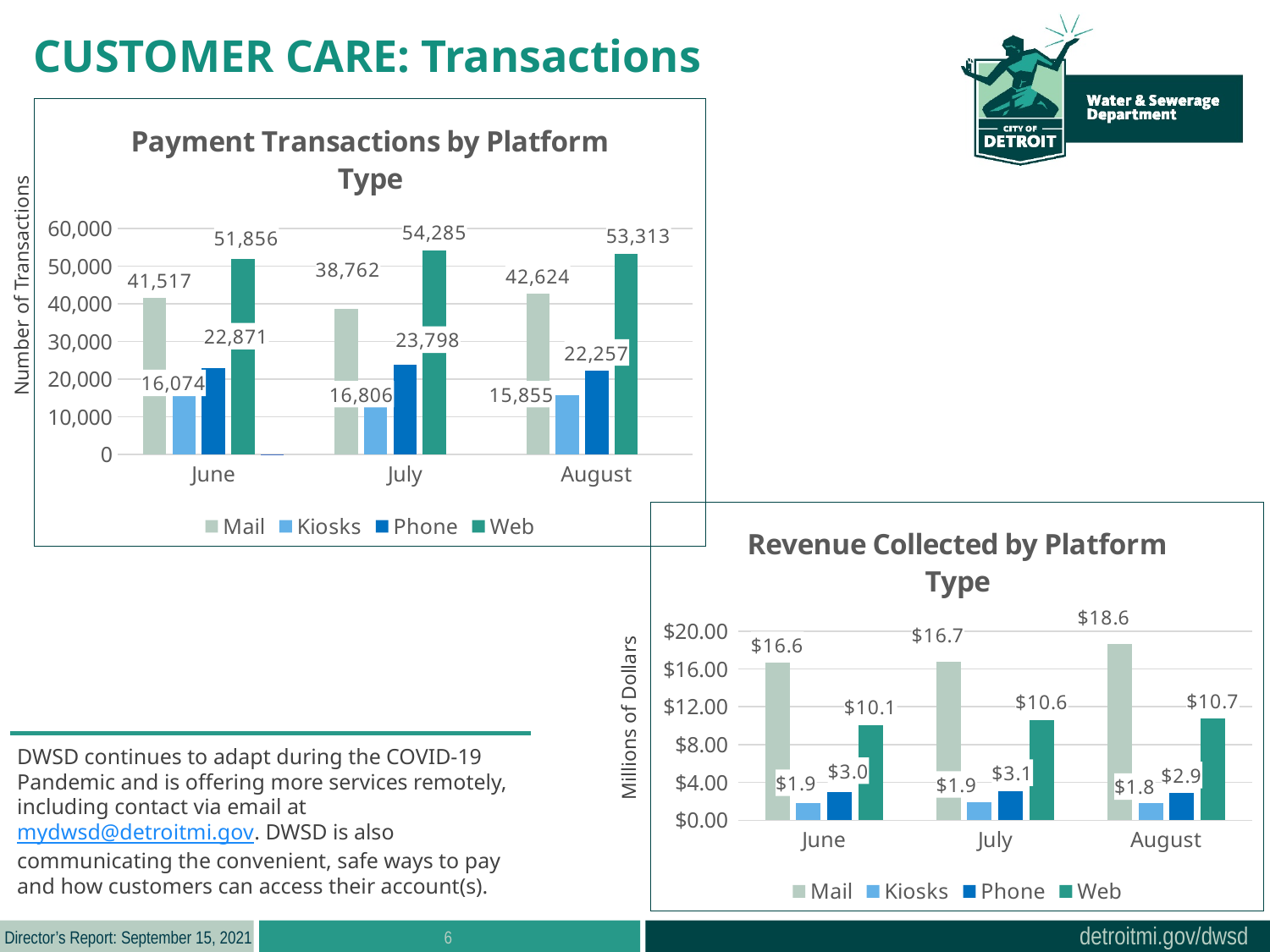
In the Payment Transactions by Platform Type chart, what is the difference between Web and Mail transactions in June? 10,339 In the Payment Transactions by Platform Type chart, which month had the highest number of Web transactions? July In the Revenue Collected by Platform Type chart, does the Mail revenue rise or fall from June to August? rise In the Payment Transactions by Platform Type chart, which month had the lowest number of Kiosks transactions? August What is the y-axis label of the Revenue Collected by Platform Type chart? Millions of Dollars In the Payment Transactions by Platform Type chart, is the value for Mail in July greater or less than 40,000? less In the Payment Transactions by Platform Type chart, how many Web transactions were there in July? 54,285 How many months are shown on the x axis of the Revenue Collected by Platform Type chart? 3 What kind of chart is the Revenue Collected by Platform Type chart? bar chart In the Revenue Collected by Platform Type chart, which collected more revenue in July, Mail or Web? Mail In the Revenue Collected by Platform Type chart, what was the revenue collected by Mail in August? $18.6 How many series does the legend of the Payment Transactions by Platform Type chart list? 4